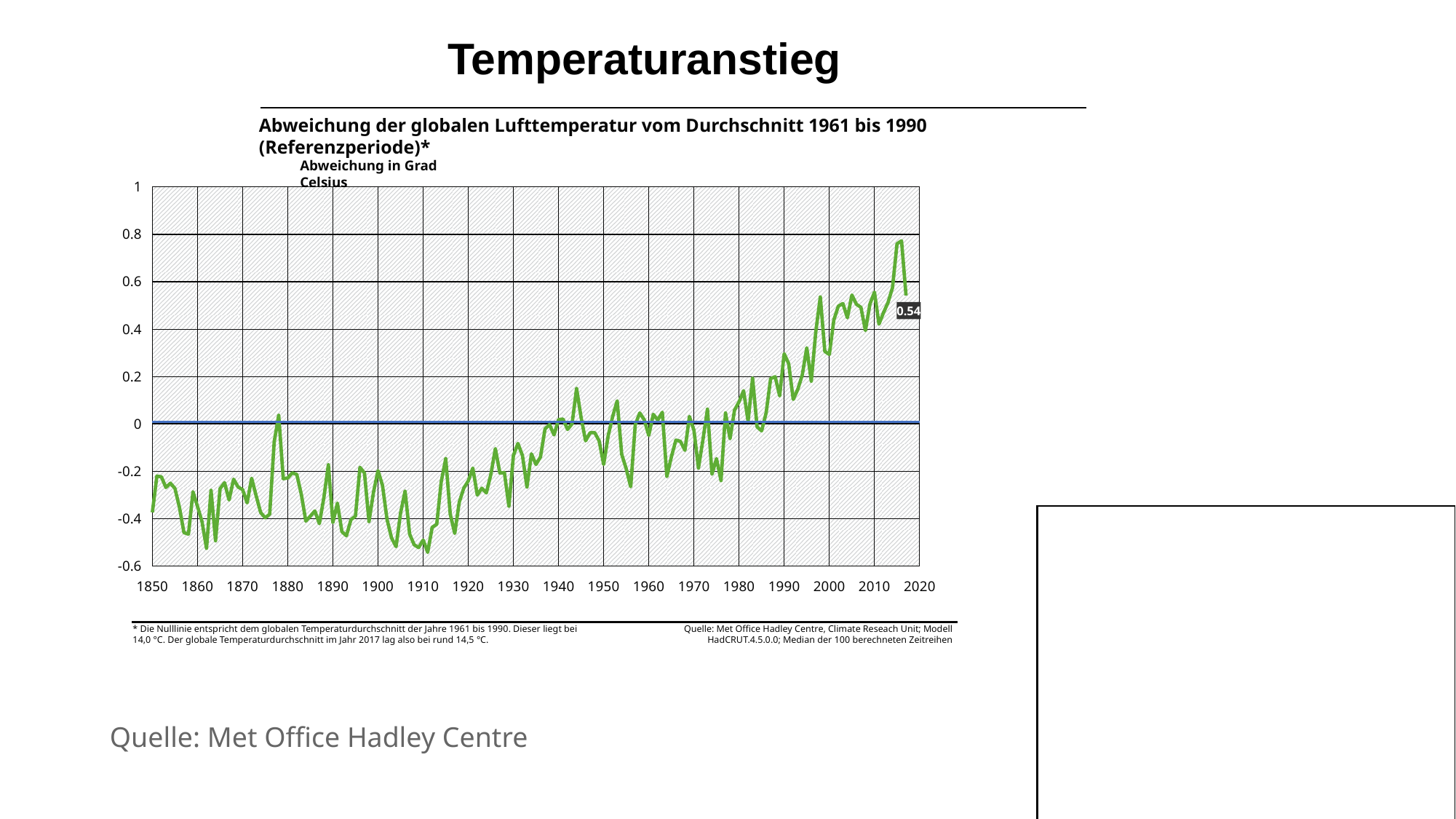
What is the label of the vertical axis? Abweichung in Grad Celsius Which is larger, the value for 1950 or the value for 2010? 2010 In which decade does the line reach its highest value? 2010s What is the value shown by the data label at the end of the line? 0.54 Is the lowest value on the line greater or less than -0.4? less Is the value for 2000 greater or less than 0.2? greater Is the highest value on the line greater or less than 0.6? greater What is the title of the chart? Abweichung der globalen Lufttemperatur vom Durchschnitt 1961 bis 1990 (Referenzperiode)* What kind of chart is shown on the slide? line chart Overall, do the values rise or fall from 1850 to 2020? rise